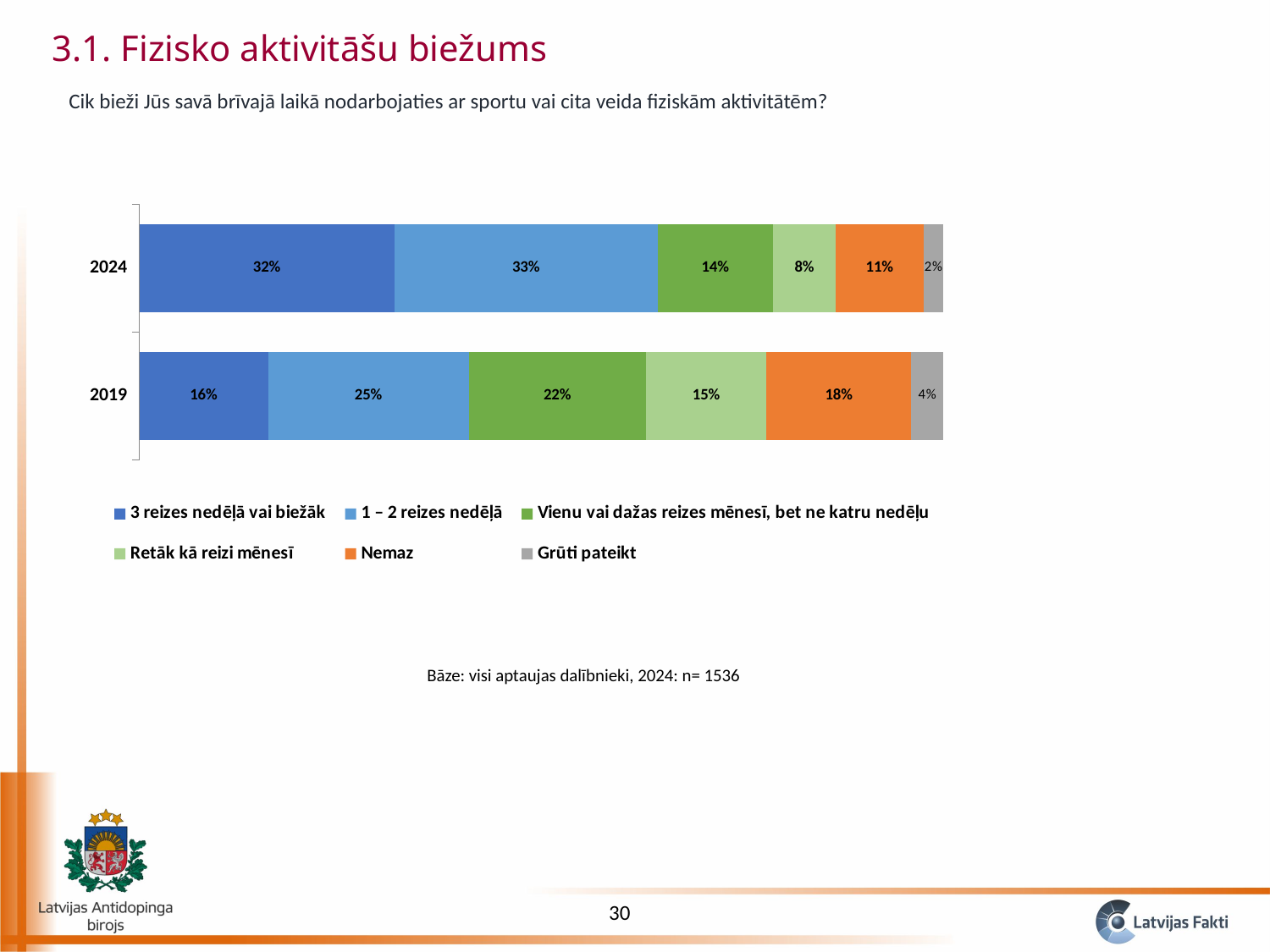
Which category has the highest value in the 2019 bar? 1 – 2 reizes nedēļā What kind of chart is shown on the slide? Stacked bar chart What percentage of respondents in 2024 reported exercising 3 times a week or more often ("3 reizes nedēļā vai biežāk")? 32% Which category has the lowest value in the 2024 bar? Grūti pateikt What is the total of the 2024 bar? 100% What is the value for "Nemaz" in 2019? 18% By how many percentage points did the share for "3 reizes nedēļā vai biežāk" change from 2019 to 2024? 16 percentage points What is the value for "1 – 2 reizes nedēļā" in 2024? 33% How many years (bars) are shown in the chart? 2 What is the value for "Grūti pateikt" in 2019? 4% How many series does the legend list? 6 Which year has the larger value for "Retāk kā reizi mēnesī", 2019 or 2024? 2019